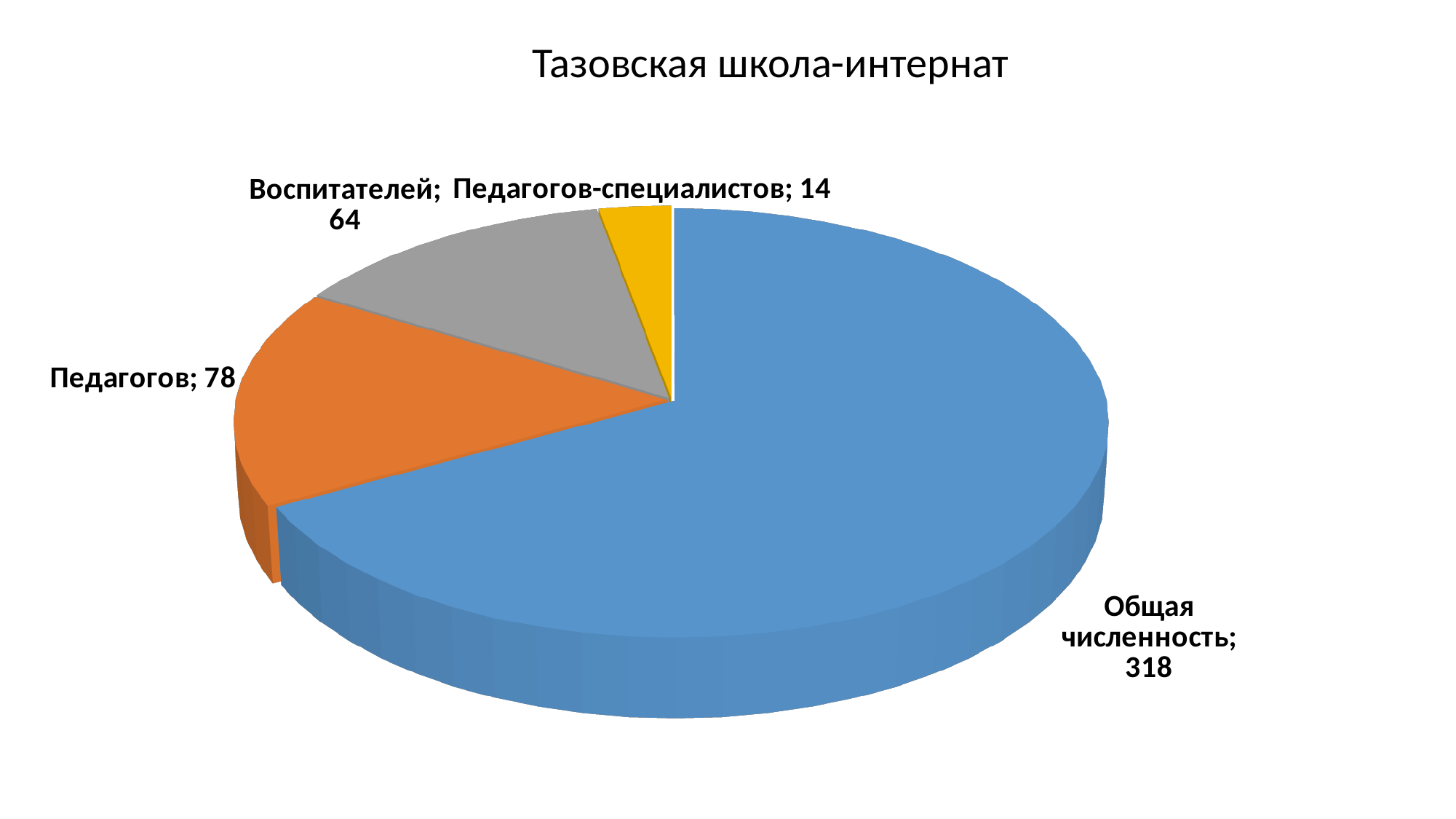
What type of chart is shown on the slide? Pie chart What is the value for Общая численность? 318 What is the difference between the values for Педагогов and Воспитателей? 14 Which is larger, the value for Воспитателей or the value for Педагогов-специалистов? Воспитателей What is the value for Воспитателей? 64 What is the title of the chart? Тазовская школа-интернат What is the value for Педагогов? 78 Which category has the largest slice? Общая численность How many slices does the pie chart have? 4 What is the value for Педагогов-специалистов? 14 Which category has the smallest slice? Педагогов-специалистов What colour is the slice for Педагогов? Orange